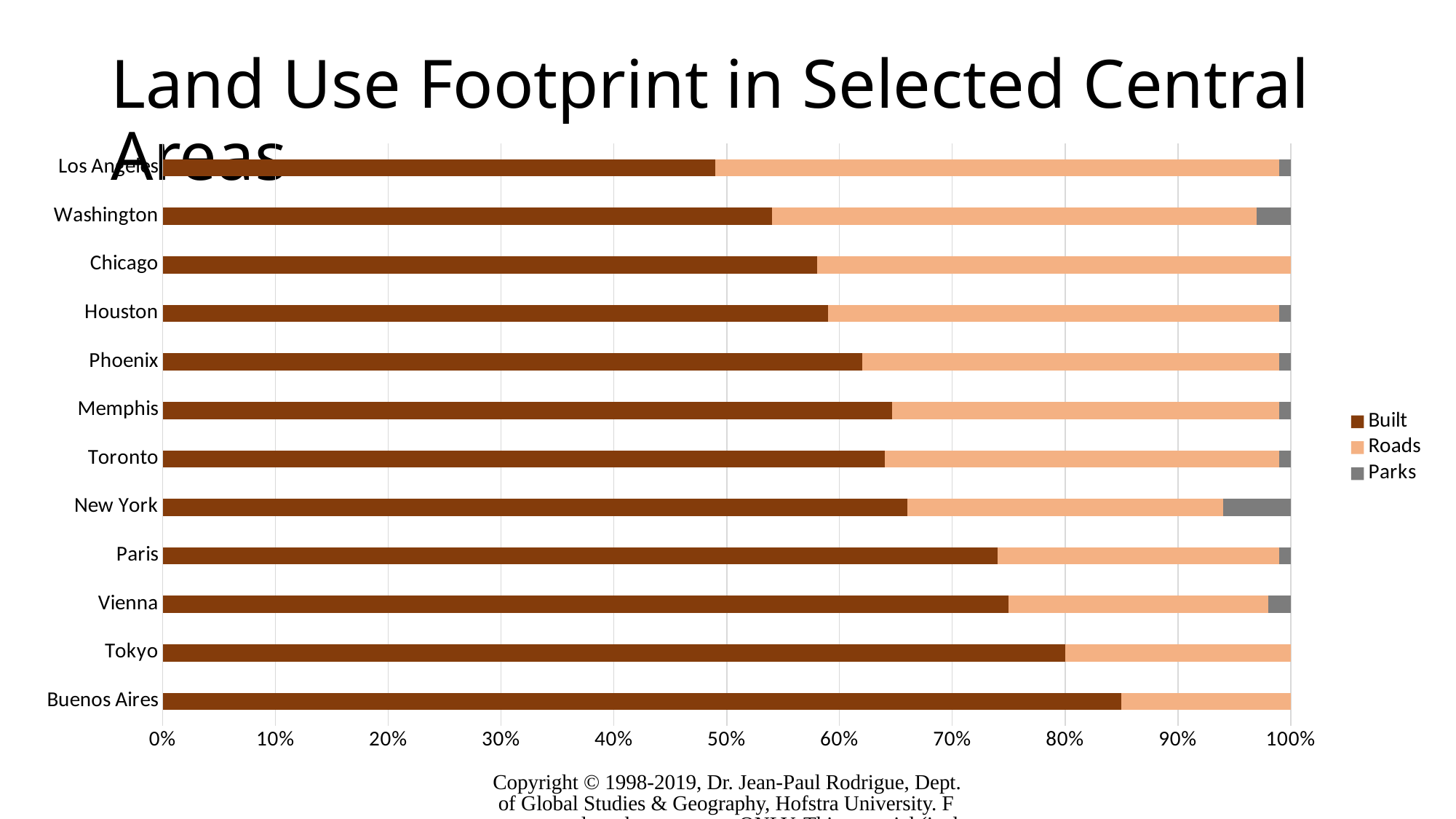
Which city has a larger Built share, Vienna or Memphis? Vienna Is the Built share for Washington greater or less than 50%? greater How many series does the legend list? 3 Going down the chart from Los Angeles to Buenos Aires, does the Built share increase or decrease? increase Which city has the largest Parks share? New York What are the three land use categories listed in the legend? Built, Roads, Parks What kind of chart is shown on the slide? Stacked bar chart Which city has the largest Built share of its land use footprint? Buenos Aires Which city has the smallest Built share of its land use footprint? Los Angeles Is the Built share for Buenos Aires greater or less than 80%? greater How many cities are listed on the chart? 12 Is the Built share for Paris greater or less than 70%? greater